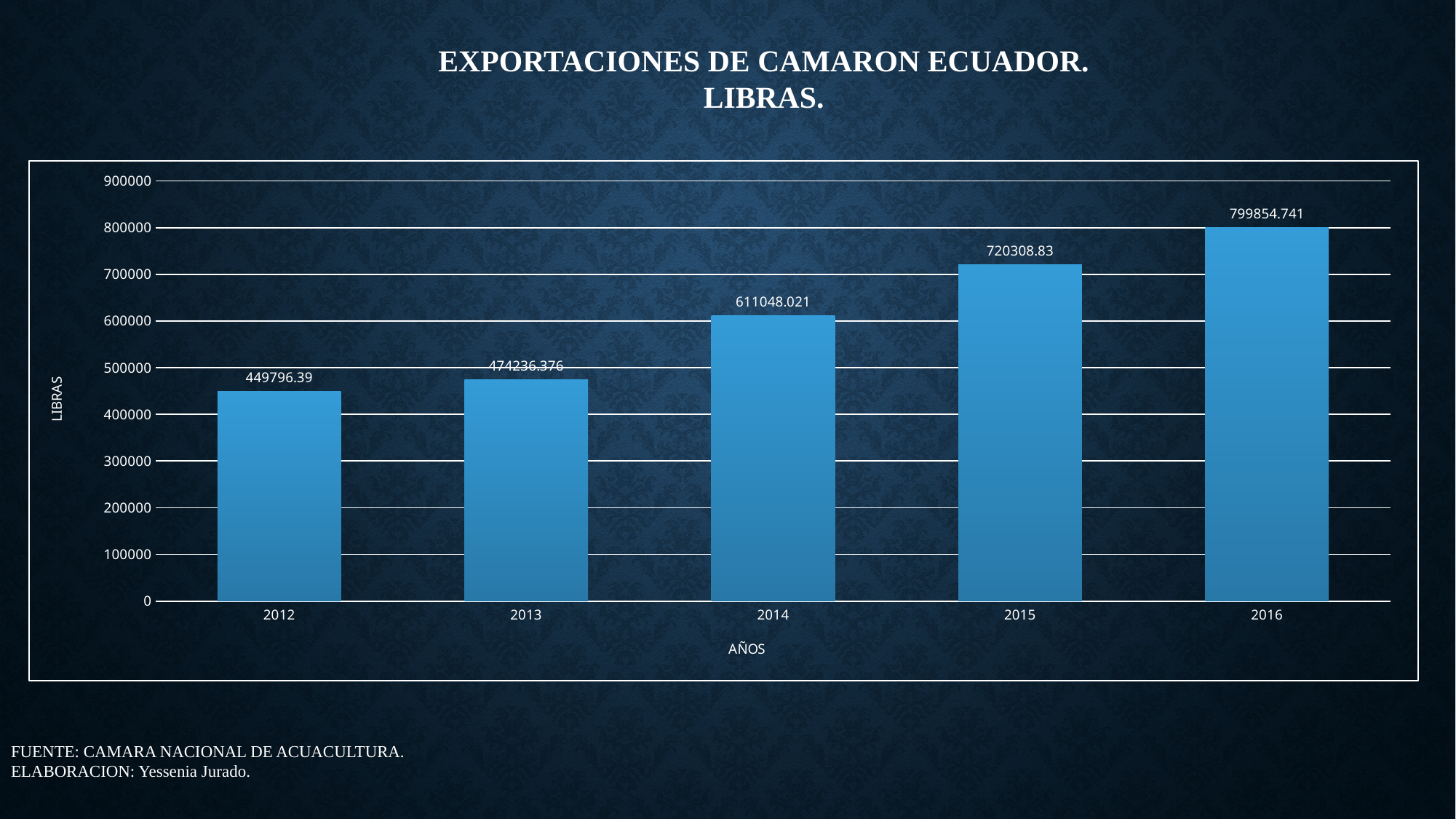
What is the value for 2012? 449796.39 Do the values rise or fall from 2012 to 2016? Rise Which year has the lowest value? 2012 What is the value for 2016? 799854.741 Is the value for 2015 greater or less than 700000? greater What is the difference between the values for 2016 and 2015? 79545.911 How many years are shown on the x axis? 5 Which is larger, the value for 2013 or the value for 2015? 2015 What is the difference between the values for 2014 and 2013? 136811.645 What type of chart is shown on the slide? Bar chart What is the value for 2014? 611048.021 Which year has the highest value? 2016